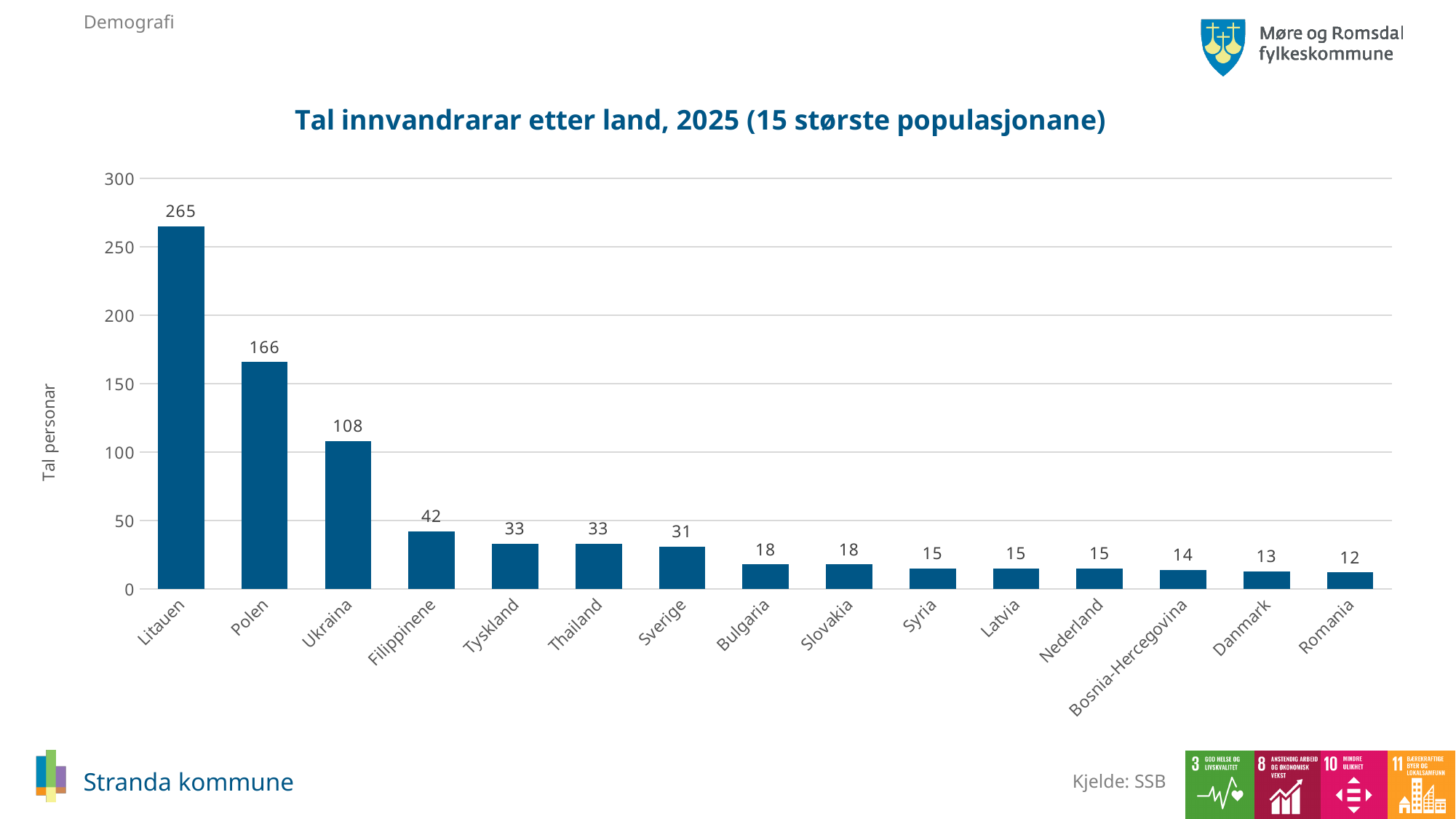
Is the value for Polen greater or less than 150? greater What is the title of the chart? Tal innvandrarar etter land, 2025 (15 største populasjonane) Which is larger, the value for Sverige or the value for Bulgaria? Sverige How many countries are shown on the chart? 15 What kind of chart is shown on the slide? bar chart What is the value for Ukraina? 108 Which country has the highest value? Litauen What is the value for Litauen? 265 What is the value for Bosnia-Hercegovina? 14 Which country has the lowest value? Romania What is the difference between the values for Litauen and Polen? 99 What is the value for Filippinene? 42